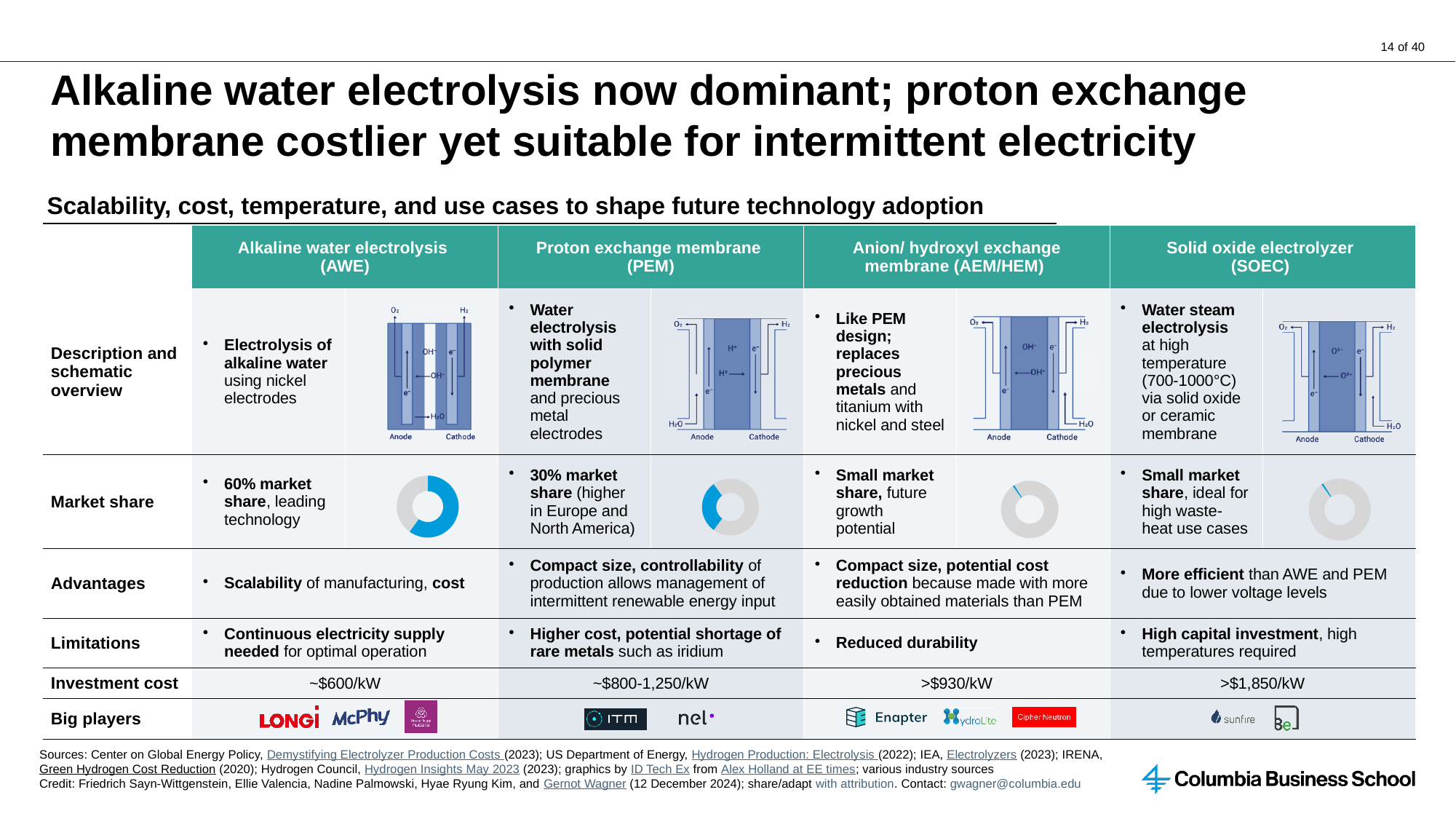
What kind of chart is used in the Market share row of the table? Donut chart What colour is used for the filled market-share segment in the donut charts? Blue In the Market share row, what is the difference in market share between AWE (60%) and PEM (30%)? 30 percentage points Which technology's donut chart in the Market share row shows the largest market share? Alkaline water electrolysis (AWE) In the Market share row, what market share is shown for Proton exchange membrane (PEM)? 30% In the Market share row, is the AEM/HEM donut chart's filled share greater or less than 10%? less How many donut charts appear in the Market share row? 4 In the Market share row, what market share is shown for Alkaline water electrolysis (AWE)? 60% In the Market share row, is the market share shown for PEM greater or less than 50%? less In the Market share row, which has the larger market share, AWE or PEM? AWE Which row of the table contains the donut charts? Market share In the Market share row, is the market share shown for AWE greater or less than 50%? greater